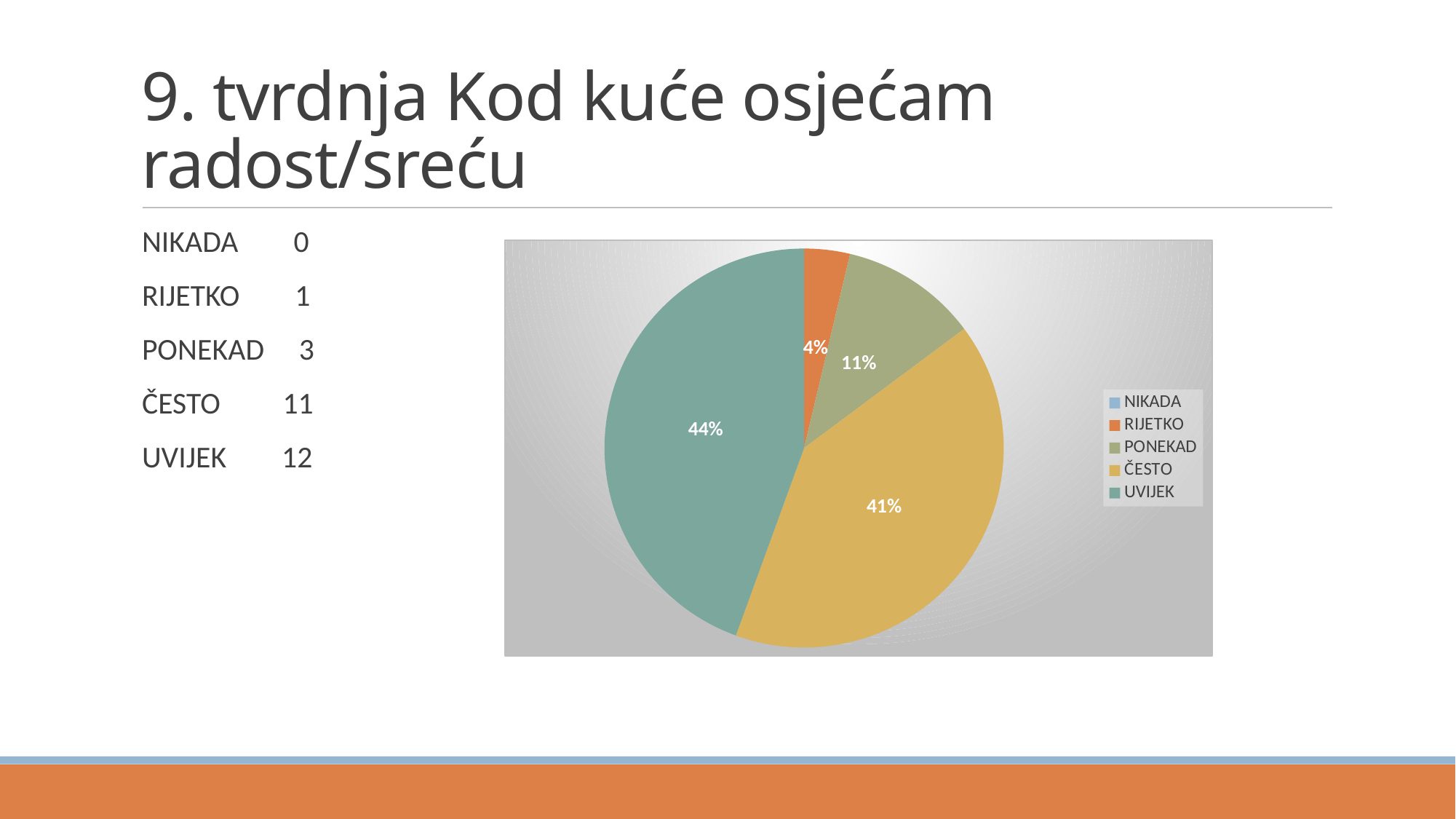
What percentage of the pie does the ČESTO slice represent? 41% What percentage of the pie does the RIJETKO slice represent? 4% How many slices with a percentage label are visible in the pie? 4 What percentage of the pie does the UVIJEK slice represent? 44% Which slice is larger, PONEKAD or RIJETKO? PONEKAD What is the difference in percentage points between the UVIJEK slice and the ČESTO slice? 3 Which category has the largest slice of the pie? UVIJEK What colour is the ČESTO slice in the pie chart? yellow How many entries does the legend list? 5 Which category with a visible slice has the smallest share of the pie? RIJETKO What kind of chart is shown on the slide? pie chart